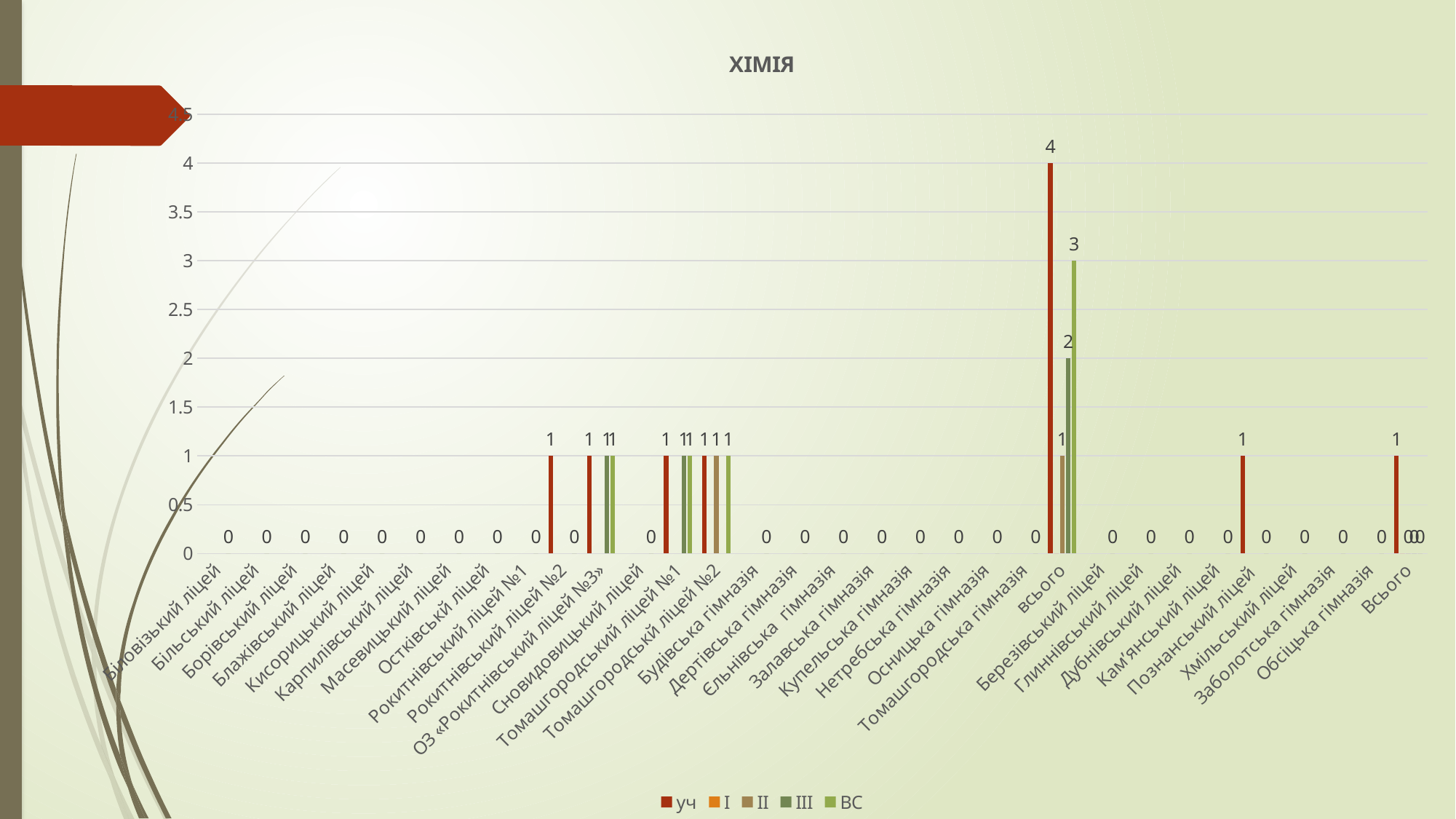
What is the difference between the уч value and the ВС value for всього? 1 What is the value of the III series for всього? 2 What is the уч value for Рокитнівський ліцей №2? 1 For всього, which is larger: the III value or the ВС value? ВС How many series does the legend list? 5 Is the уч value for всього greater or less than 3? greater What is the title of the chart? ХІМІЯ What kind of chart is shown on the slide? bar chart Which category has the highest уч value? всього What is the value of the ВС series for всього? 3 What is the value of the уч series for всього? 4